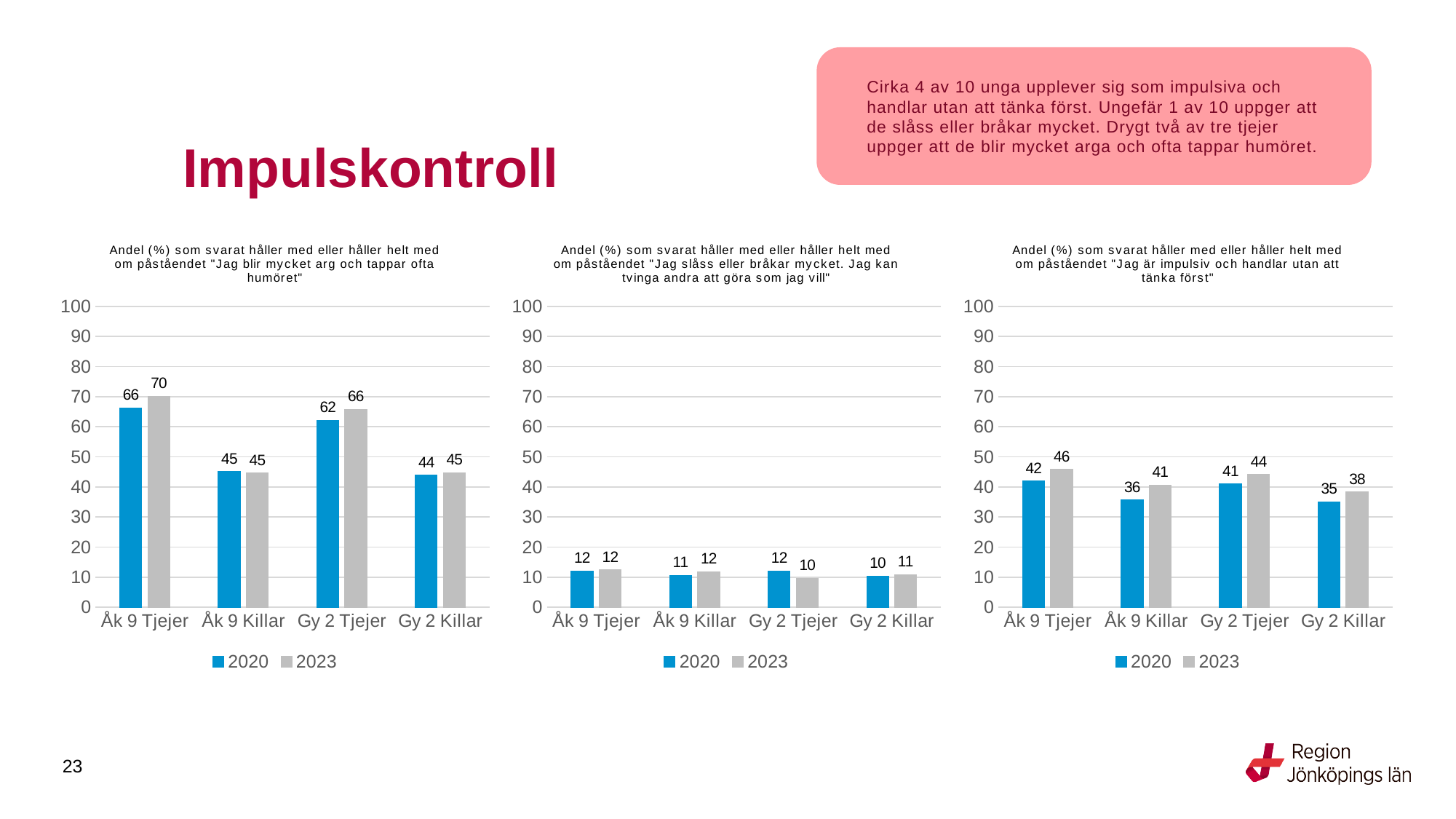
In the middle chart ("Jag slåss eller bråkar mycket"), is the 2020 value for Åk 9 Tjejer greater or less than 20? less In the left chart ("Jag blir mycket arg och tappar ofta humöret"), what is the difference between the 2023 and 2020 values for Gy 2 Tjejer? 4 In the right chart ("Jag är impulsiv och handlar utan att tänka först"), which category has the highest 2023 value? Åk 9 Tjejer How many series does the legend of the left chart list? 2 In the right chart ("Jag är impulsiv och handlar utan att tänka först"), what is the difference between the 2023 and 2020 values for Åk 9 Killar? 5 In the middle chart ("Jag slåss eller bråkar mycket"), what is the value for Gy 2 Tjejer in 2023? 10 In the right chart ("Jag är impulsiv och handlar utan att tänka först"), which is larger: the 2020 value for Gy 2 Tjejer or the 2020 value for Gy 2 Killar? Gy 2 Tjejer In the right chart ("Jag är impulsiv och handlar utan att tänka först"), what is the value for Åk 9 Killar in 2020? 36 In the left chart ("Jag blir mycket arg och tappar ofta humöret"), which category has the lowest 2020 value? Gy 2 Killar In the left chart ("Jag blir mycket arg och tappar ofta humöret"), what is the value for Åk 9 Tjejer in 2023? 70 What type of chart is the middle chart ("Jag slåss eller bråkar mycket")? Bar chart In the middle chart ("Jag slåss eller bråkar mycket"), how many categories are shown on the x axis? 4